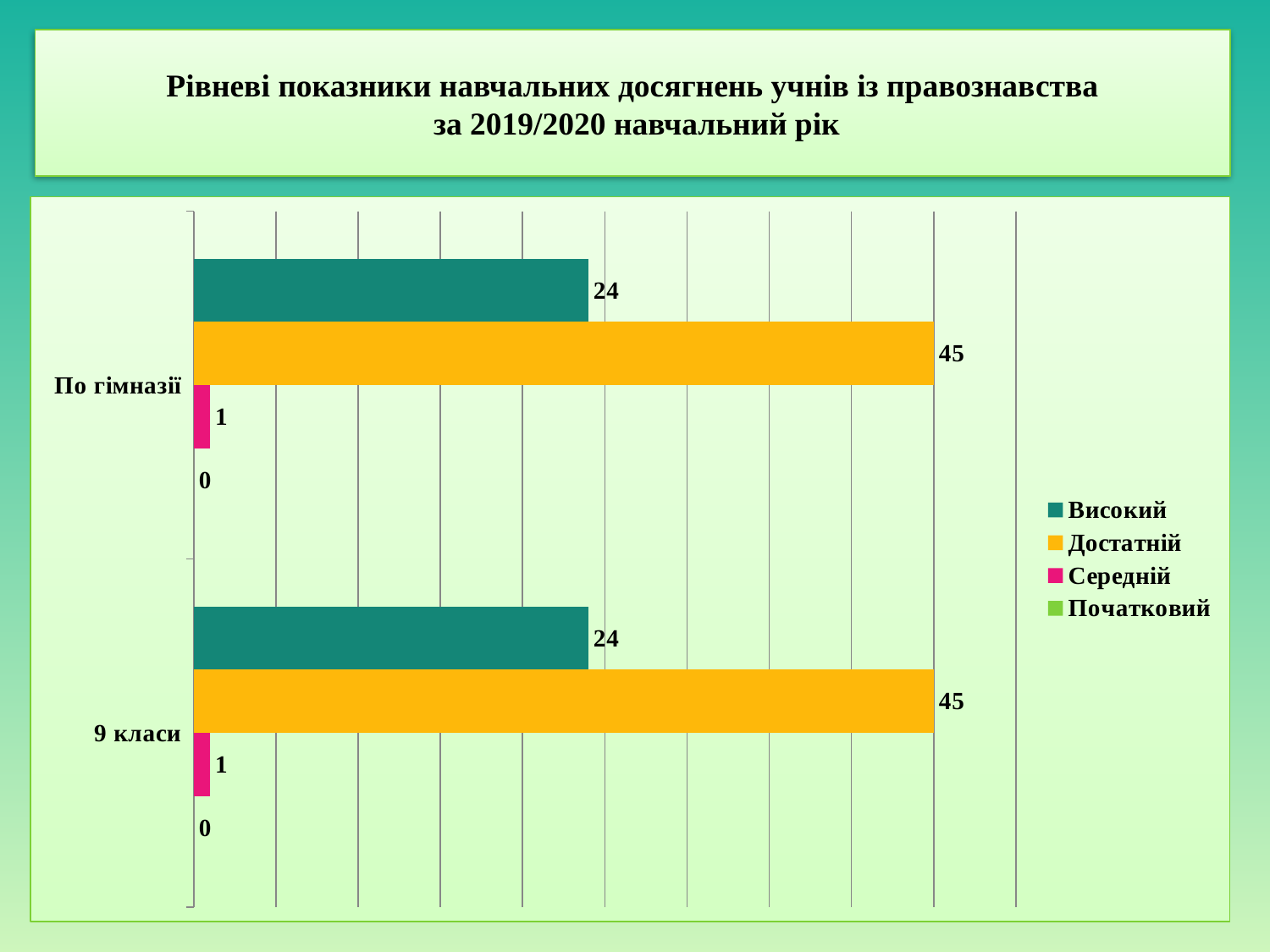
What is the value for Високий in the По гімназії category? 24 How many categories are shown on the vertical axis? 2 What kind of chart is shown on the slide? bar chart Which series has the highest value in the 9 класи category? Достатній What is the value for Достатній in the 9 класи category? 45 What is the value for Початковий in the По гімназії category? 0 Which series has the lowest value in the По гімназії category? Початковий What colour are the Достатній bars? yellow/orange Which is larger in the 9 класи category, Високий or Середній? Високий What is the difference between the Достатній and Високий values in the По гімназії category? 21 How many series does the legend list? 4 What is the value for Середній in the 9 класи category? 1